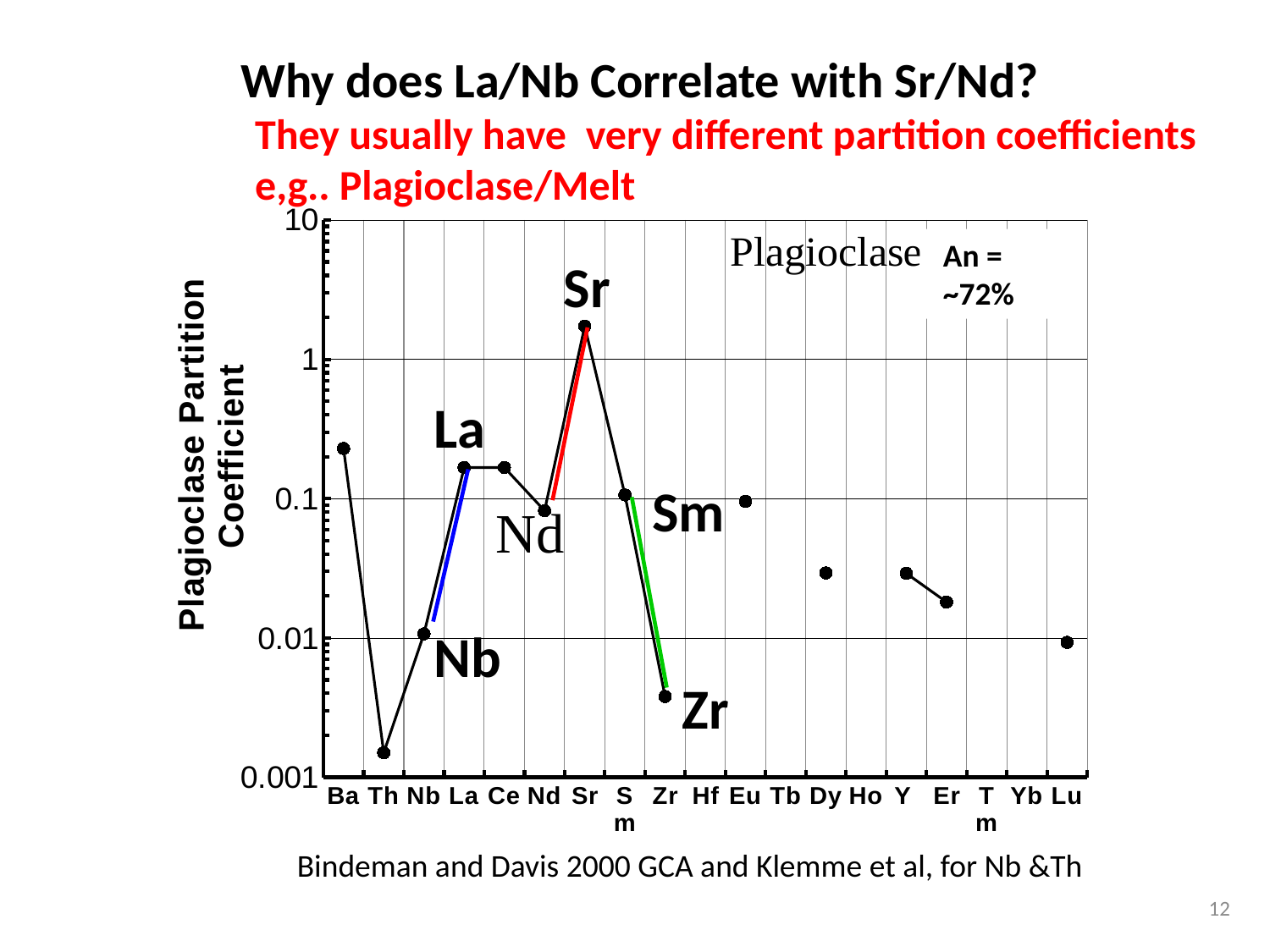
Is the plagioclase partition coefficient for Sr greater or less than 1? greater How many element labels are shown along the x axis of the chart? 19 Is the plagioclase partition coefficient for La greater or less than 0.1? greater Which has the larger plagioclase partition coefficient, Sm or Zr? Sm Which has the larger plagioclase partition coefficient, Sr or Nd? Sr What is the label on the y axis of the chart? Plagioclase Partition Coefficient Which has the larger plagioclase partition coefficient, La or Nb? La Is the plagioclase partition coefficient for Dy greater or less than 0.1? less Which element has the highest plagioclase partition coefficient on the chart? Sr Which element has the lowest plagioclase partition coefficient on the chart? Th